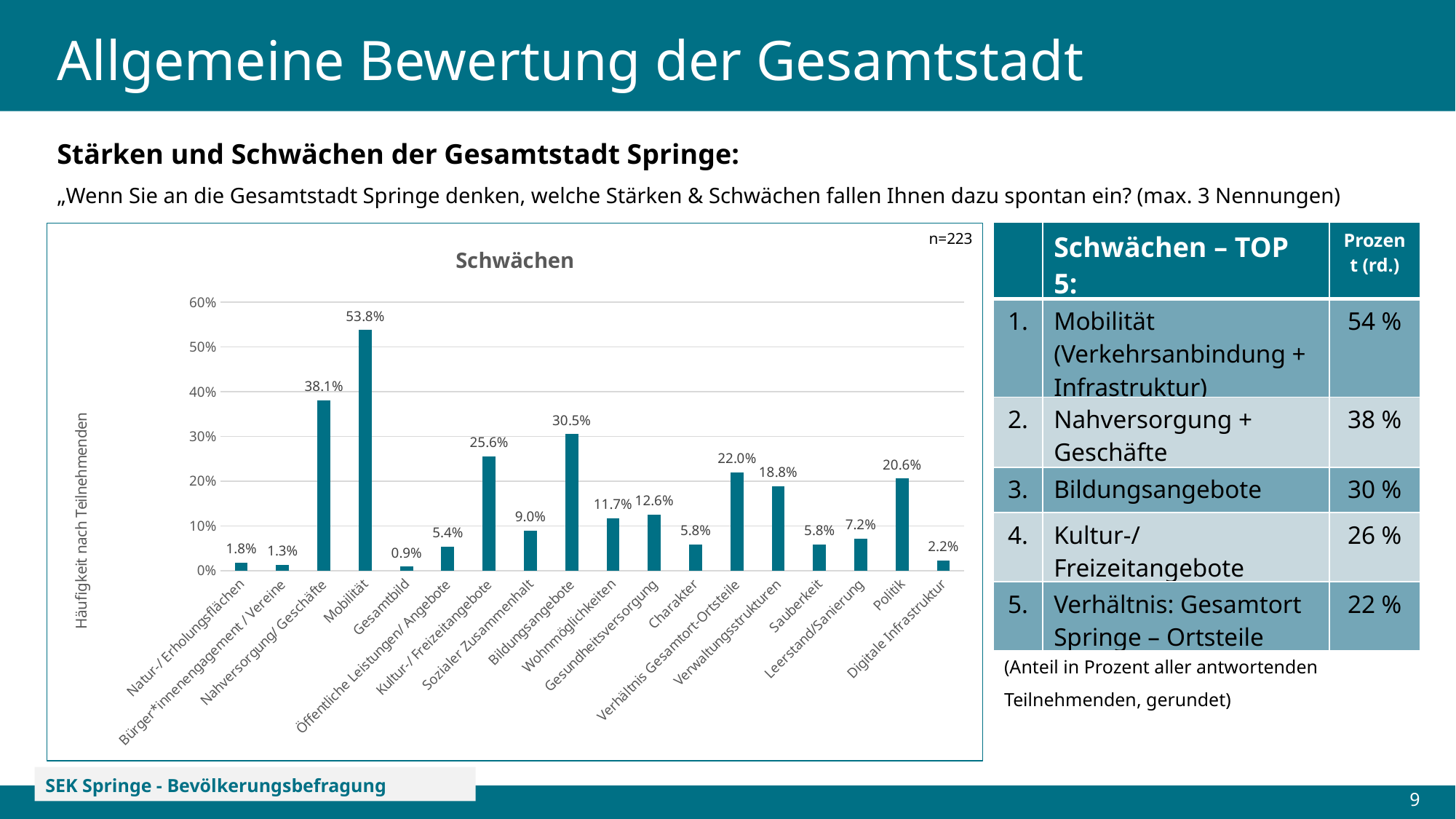
Which category has the highest value in the Schwächen chart? Mobilität Which has a larger value in the Schwächen chart, Verwaltungsstrukturen or Politik? Politik What is the value for Bildungsangebote in the Schwächen chart? 30.5% What kind of chart is shown on the slide? Bar chart What is the value for Mobilität in the Schwächen chart? 53.8% What is the title of the chart on the slide? Schwächen What is the value for Gesundheitsversorgung in the Schwächen chart? 12.6% What is the value for Politik in the Schwächen chart? 20.6% What is the sample size (n) shown on the Schwächen chart? n=223 How many categories are shown in the Schwächen chart? 18 Which category has the lowest value in the Schwächen chart? Gesamtbild What is the difference between the values for Mobilität and Nahversorgung/ Geschäfte in the Schwächen chart? 15.7 percentage points